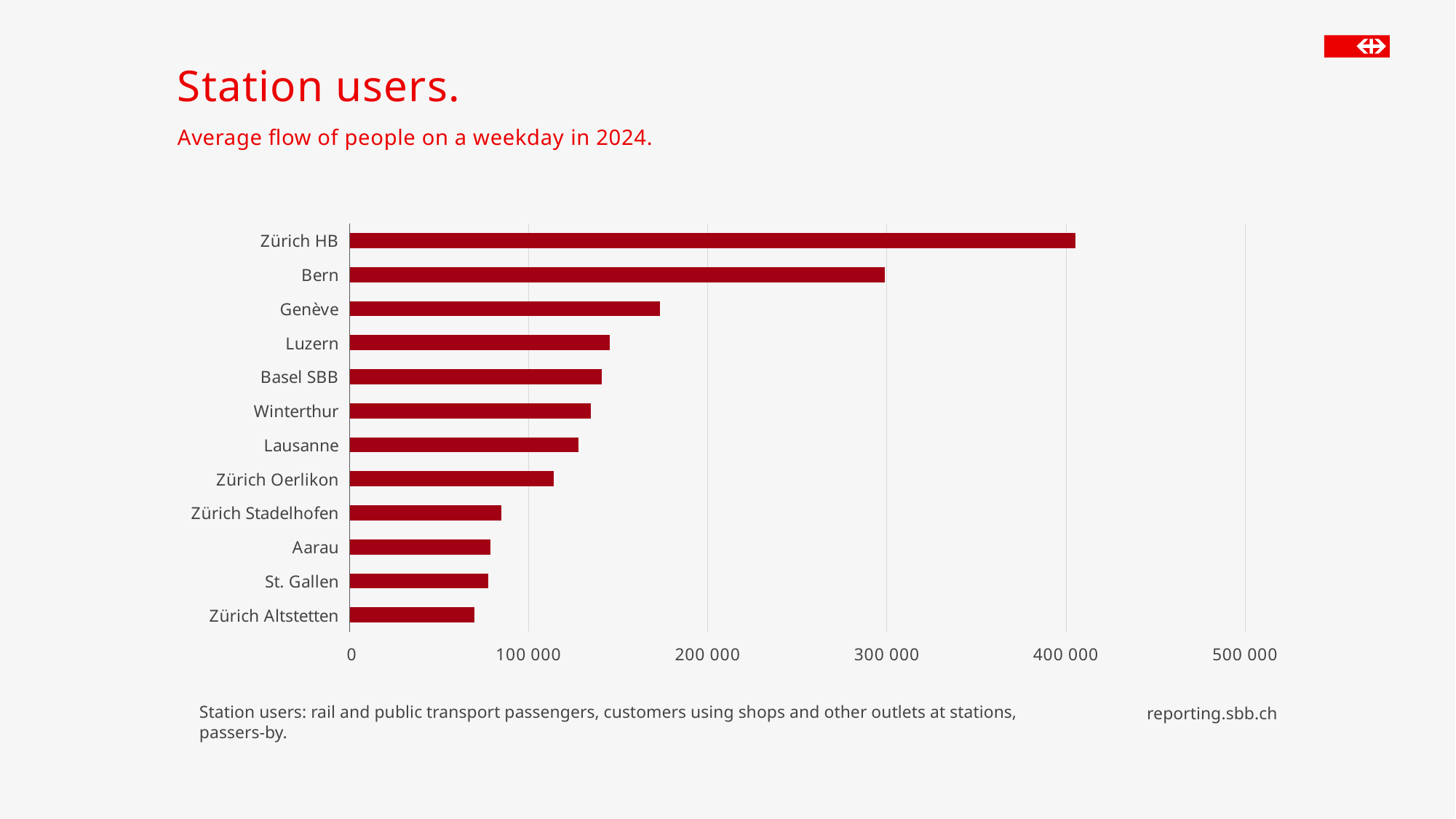
Which station has the lowest average flow of people? Zürich Altstetten Which has a higher value, Genève or Luzern? Genève Is the value for Zürich Stadelhofen greater or less than 100 000? less Is the value for Zürich HB greater or less than 400 000? greater How many stations are shown in the chart? 12 What kind of chart is shown on the slide? bar chart What is the title of the slide? Station users. Which station has the highest average flow of people? Zürich HB Do the bar values increase or decrease going from the top station to the bottom station? decrease Which has a higher value, Lausanne or Zürich Oerlikon? Lausanne Is the value for Genève greater or less than 200 000? less